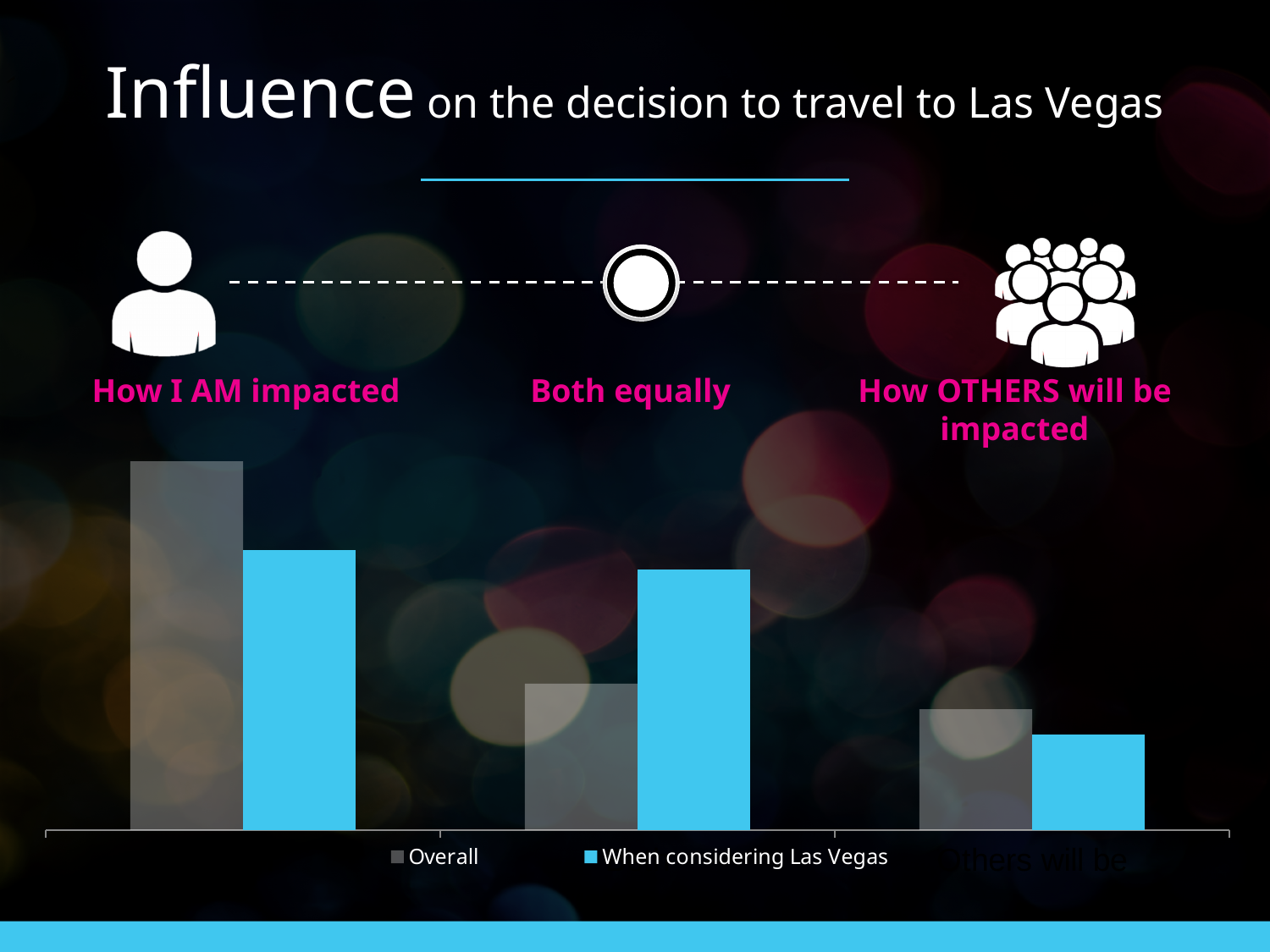
What colour are the bars for the When considering Las Vegas series? blue How many series does the chart legend list? 2 For How I AM impacted, which is larger: Overall or When considering Las Vegas? Overall What kind of chart is shown on the slide? bar chart For Both equally, which is larger: Overall or When considering Las Vegas? When considering Las Vegas Which category has the lowest value for When considering Las Vegas? How OTHERS will be impacted What are the two series named in the chart legend? Overall and When considering Las Vegas How many categories are plotted in the chart? 3 Which category has the highest Overall value? How I AM impacted Which category has the highest value for When considering Las Vegas? How I AM impacted Do the Overall values rise or fall from left to right across the categories? fall Which category has the lowest Overall value? How OTHERS will be impacted